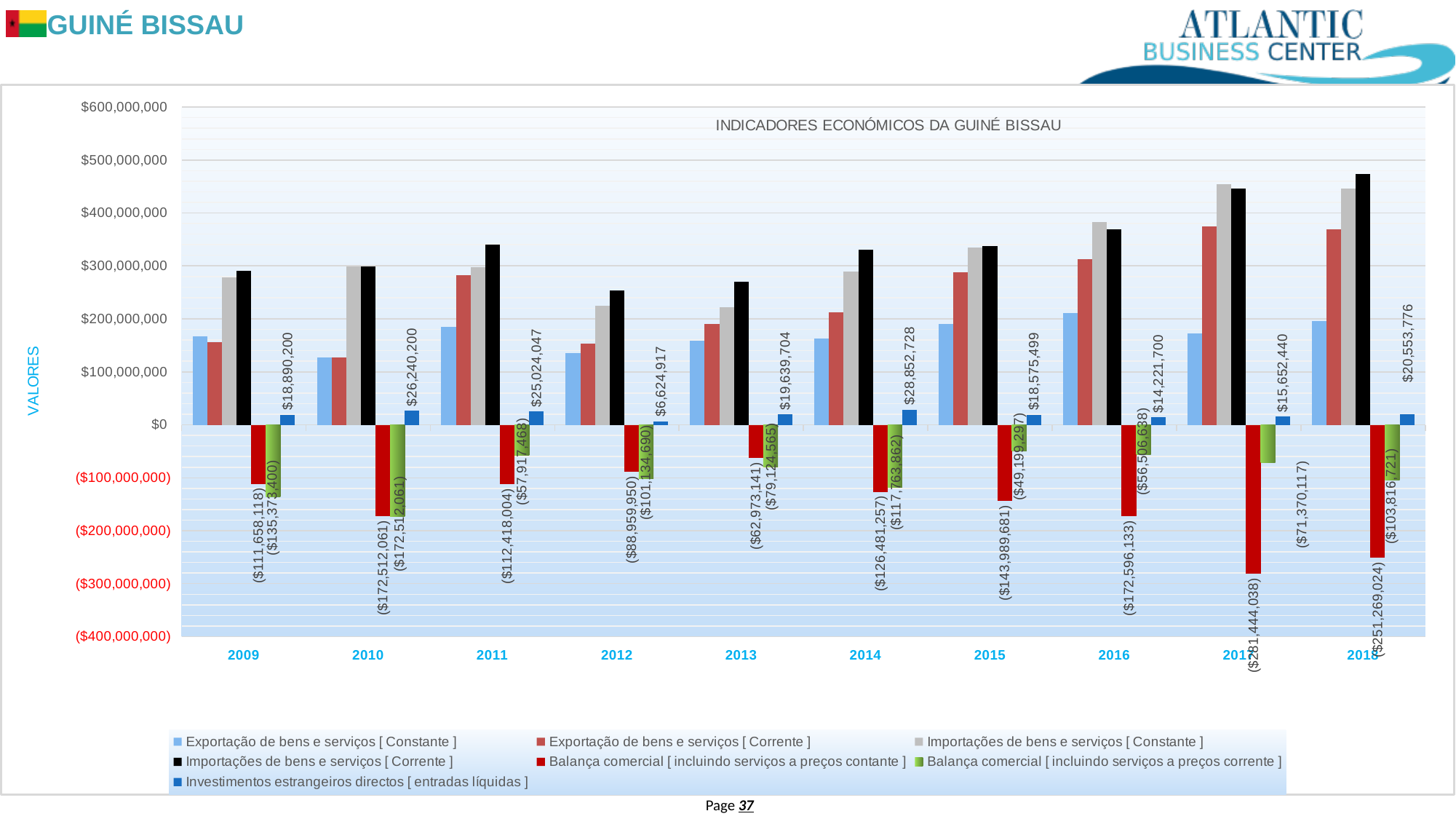
In which year is Investimentos estrangeiros directos [entradas líquidas] lowest? 2012 How many years are shown on the x axis of the chart? 10 What is the value of Investimentos estrangeiros directos [entradas líquidas] in 2014? $28,852,728 Which year has the larger value of Investimentos estrangeiros directos [entradas líquidas], 2010 or 2011? 2010 In which year is Investimentos estrangeiros directos [entradas líquidas] highest? 2014 What is the value of Balança comercial [incluindo serviços a preços corrente] in 2015? ($49,199,297) What is the title of the chart? INDICADORES ECONÓMICOS DA GUINÉ BISSAU By how much does Investimentos estrangeiros directos [entradas líquidas] in 2018 exceed the value in 2017? $4,901,336 How many series does the chart legend list? 7 What is the value of Balança comercial [incluindo serviços a preços contante] in 2017? ($281,444,038) What kind of chart is shown on the slide? bar chart What is the value of Investimentos estrangeiros directos [entradas líquidas] in 2012? $6,624,917